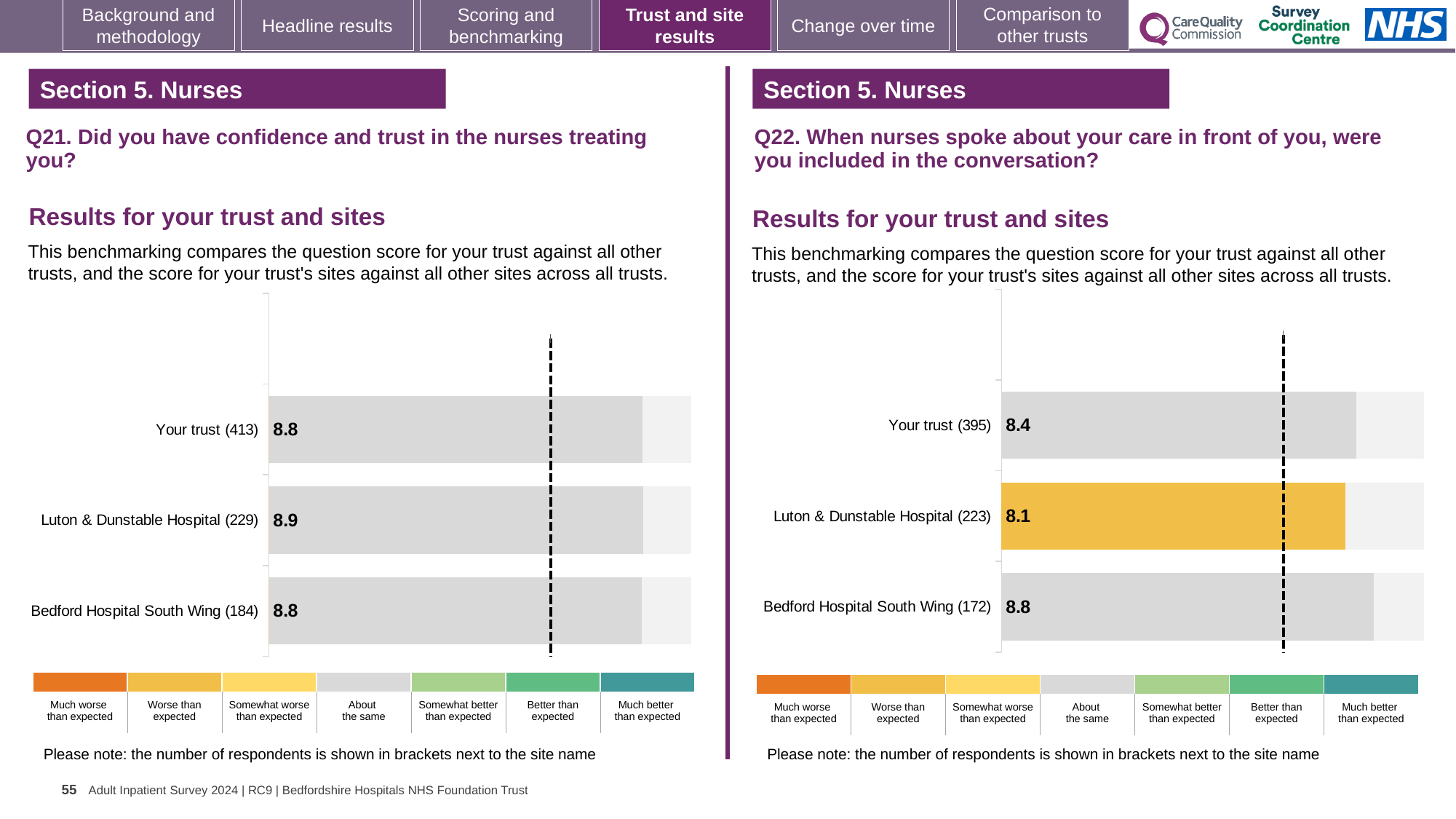
In the Q22 chart on the right, what is the score for Bedford Hospital South Wing? 8.8 In the Q21 chart on the left, what is the score for Luton & Dunstable Hospital? 8.9 In the Q22 chart on the right, which benchmark category does the colour of the Luton & Dunstable Hospital bar correspond to? Worse than expected In the Q22 chart on the right, what is the difference between the scores for Bedford Hospital South Wing and Luton & Dunstable Hospital? 0.7 In the Q22 chart on the right, which site or trust has the lowest score? Luton & Dunstable Hospital In the Q22 chart on the right, what is the score for Luton & Dunstable Hospital? 8.1 What type of chart is used for the Q21 results on the left? Bar chart How many bars are plotted in the Q21 chart on the left? 3 In the Q22 chart on the right, which site or trust has the highest score? Bedford Hospital South Wing In the Q22 chart on the right, how many respondents are shown in brackets for Your trust? 395 In the Q22 chart on the right, which has the larger score, Your trust or Bedford Hospital South Wing? Bedford Hospital South Wing In the Q21 chart on the left, what is the score for Your trust? 8.8